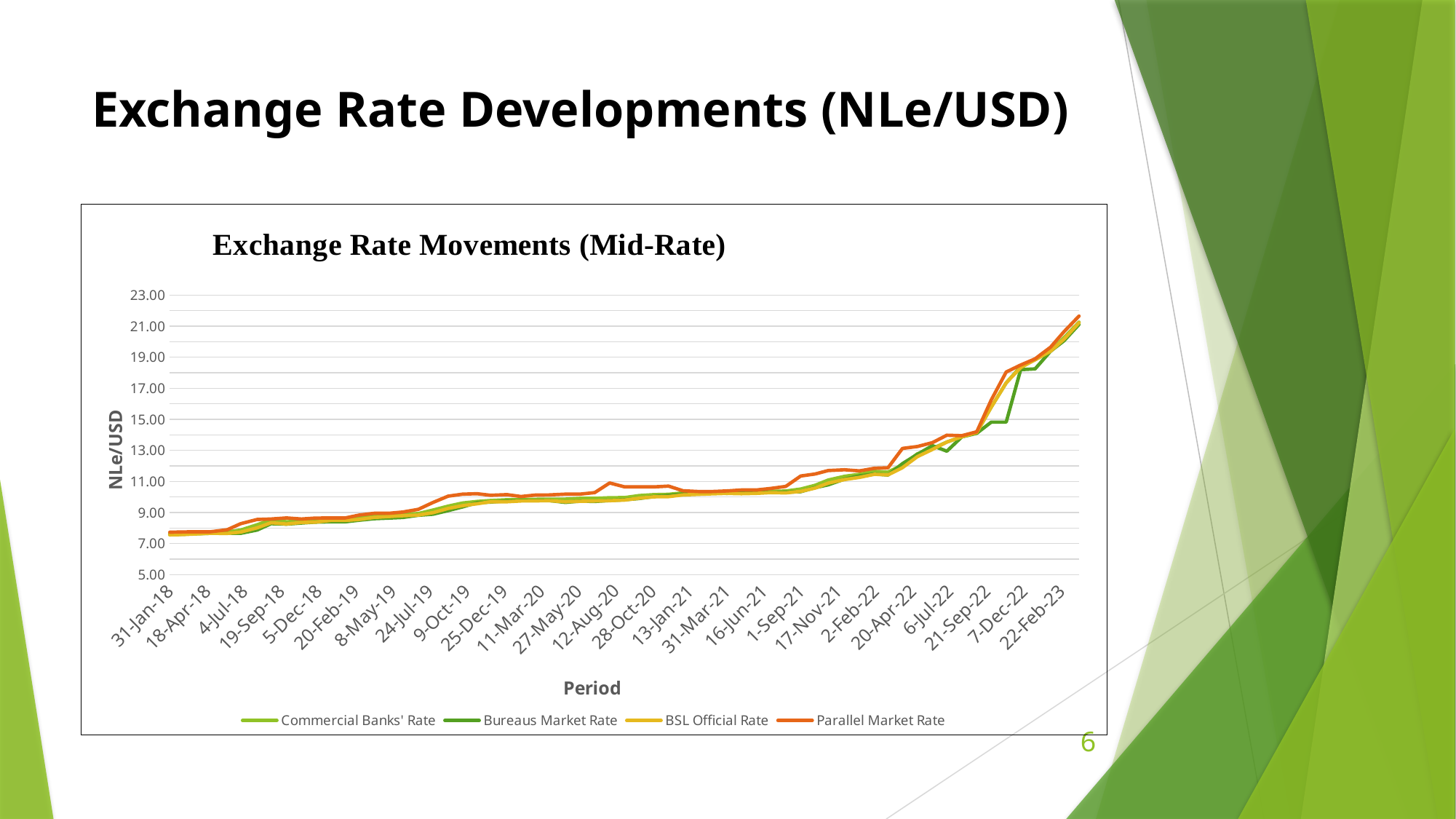
Is the Parallel Market Rate at 31-Jan-18 greater or less than 9.00? less What is the title of the chart? Exchange Rate Movements (Mid-Rate) Do the exchange rates rise or fall from 31-Jan-18 to 22-Feb-23? Rise Which series is generally the highest across the period? Parallel Market Rate Is the Commercial Banks' Rate at 16-Jun-21 greater or less than 13.00? less How many series does the legend list? 4 Is the Parallel Market Rate at 12-Aug-20 greater or less than 13.00? less At 12-Aug-20, which is higher: the Parallel Market Rate or the BSL Official Rate? Parallel Market Rate What kind of chart is shown on the slide? Line chart What is the label of the vertical axis? NLe/USD